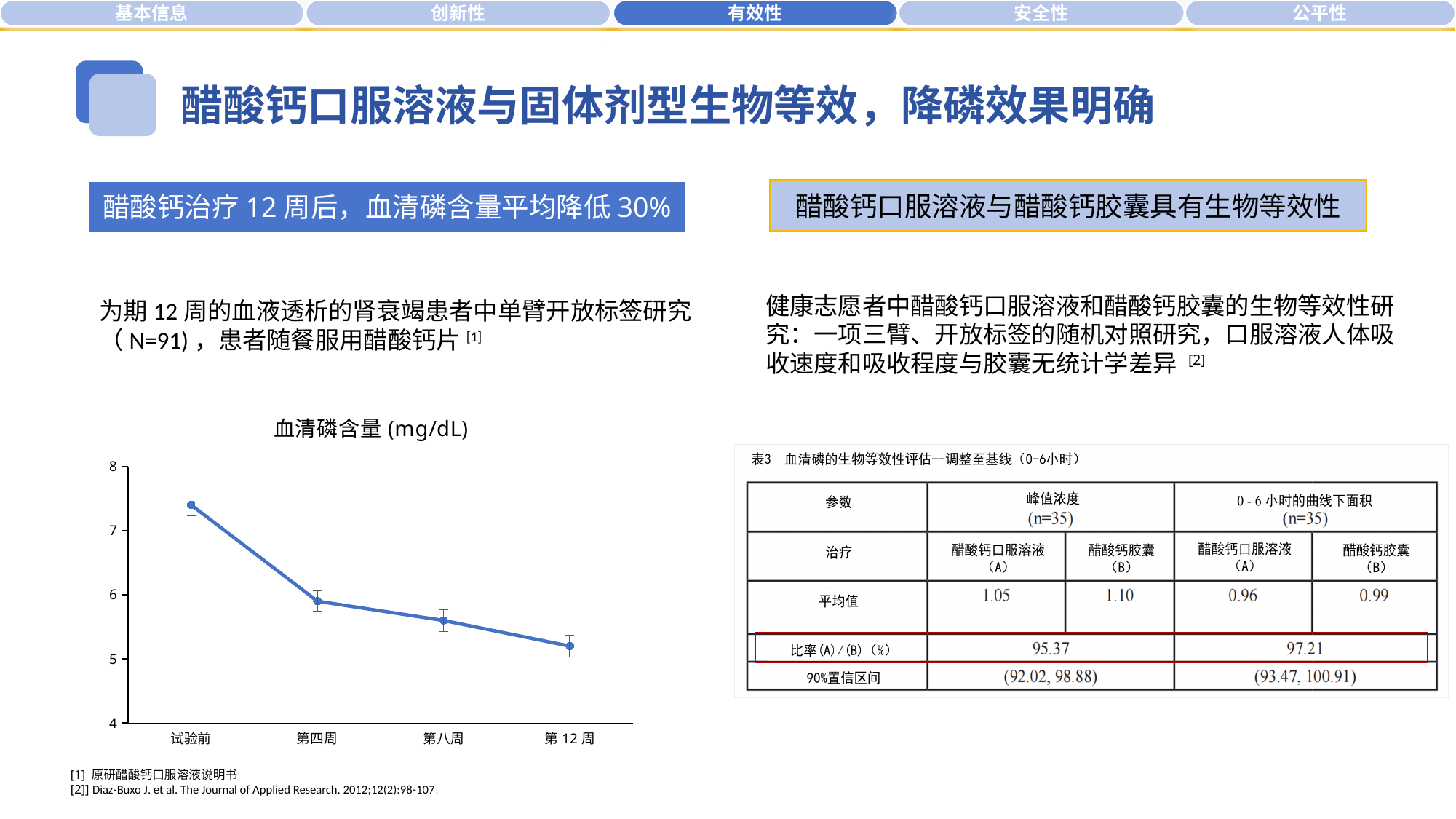
Do the values rise or fall from 试验前 to 第 12 周? fall Is the value for 第八周 greater or less than 6? less What kind of chart is shown on the slide? line chart Is the value for 第四周 greater or less than 6? less Which time point has the highest serum phosphorus value? 试验前 What is the title of the chart? 血清磷含量 (mg/dL) Is the value for 试验前 greater or less than 7? greater Which time point has the lowest serum phosphorus value? 第 12 周 Which is larger, the value for 第四周 or the value for 第 12 周? 第四周 Which is larger, the value for 试验前 or the value for 第八周? 试验前 How many time points are plotted on the chart? 4